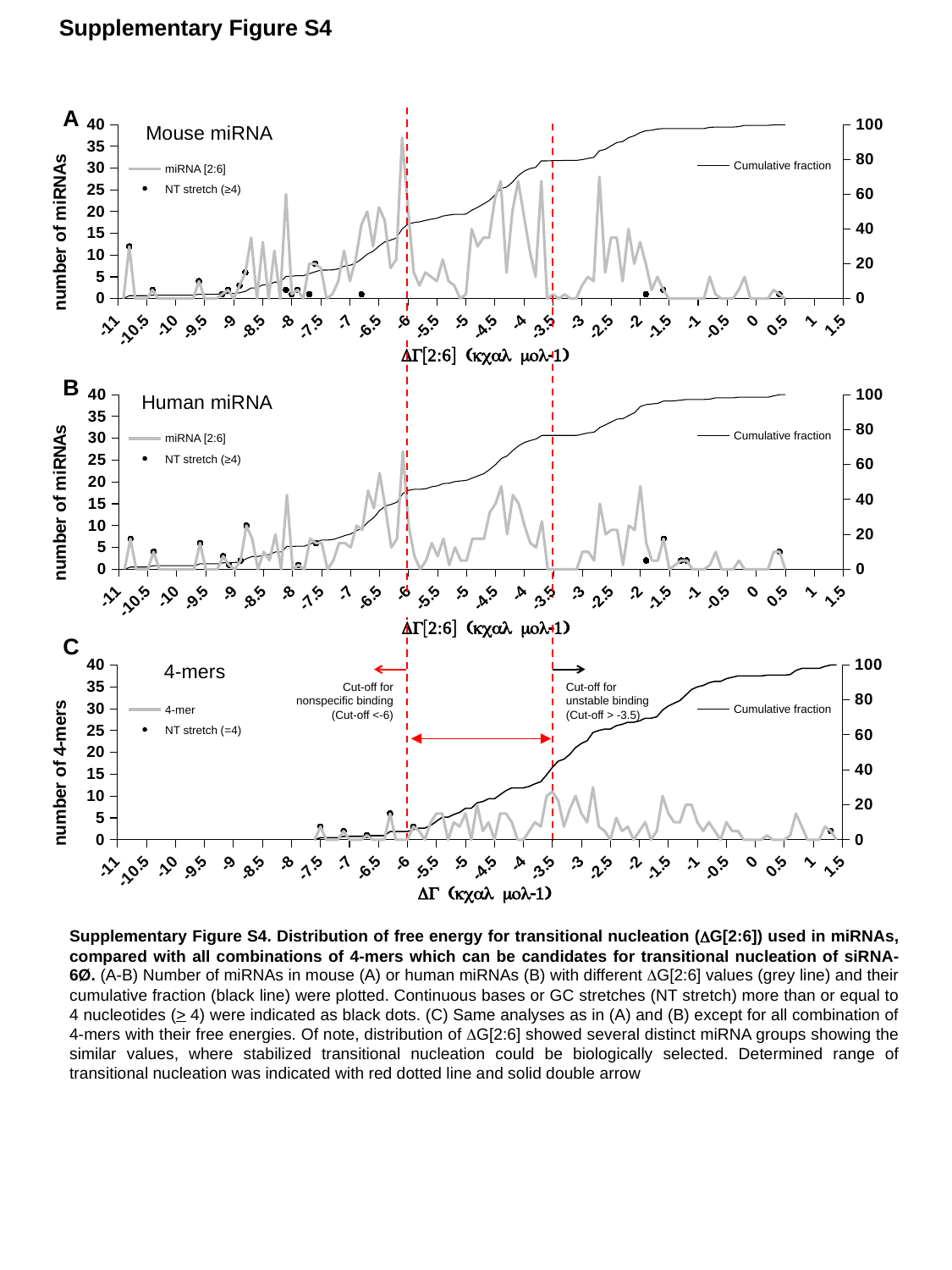
In the 4-mers chart (panel C), what cut-off value is labelled for nonspecific binding? Cut-off < -6 What kind of chart is the Mouse miRNA chart (panel A)? line chart In the 4-mers chart (panel C), is the cumulative fraction at ΔG = -6 greater or less than 20? less How many series does the legend of the Human miRNA chart (panel B) list? 3 In the Human miRNA chart (panel B), does the cumulative fraction line rise or fall as ΔG[2:6] increases along the x axis? rise In the Mouse miRNA chart (panel A), is the cumulative fraction at ΔG[2:6] = 0 greater or less than 80? greater In the Human miRNA chart (panel B), is the peak value of the miRNA [2:6] grey line near ΔG[2:6] = -6 greater or less than 20? greater What is the title shown inside the top chart (panel A)? Mouse miRNA